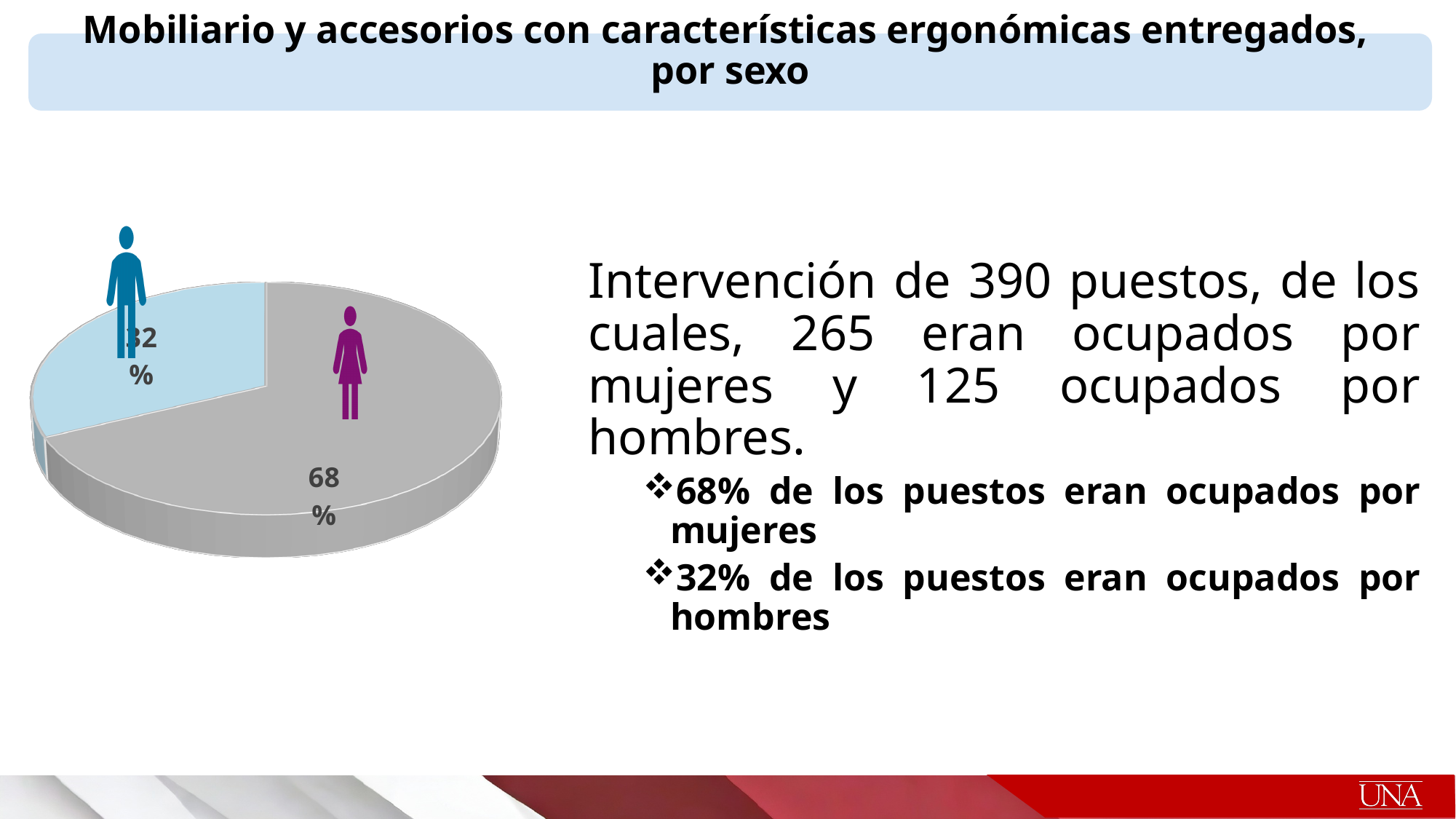
Which slice is larger, the one labelled 68% or the one labelled 32%? 68% What colour is the slice labelled 68%? gray Which group has the smallest slice in the pie chart? hombres (men) What do the two slices of the pie chart add up to? 100% How many slices does the pie chart have? 2 What kind of chart is shown on the slide? pie chart What is the difference in percentage points between the women's slice and the men's slice? 36 What share of the pie chart corresponds to positions occupied by men (hombres)? 32% What share of the pie chart corresponds to positions occupied by women (mujeres)? 68% Which group has the largest slice in the pie chart? mujeres (women) Is the share for men (hombres) greater or less than 50%? less What colour is the slice labelled 32%? light blue